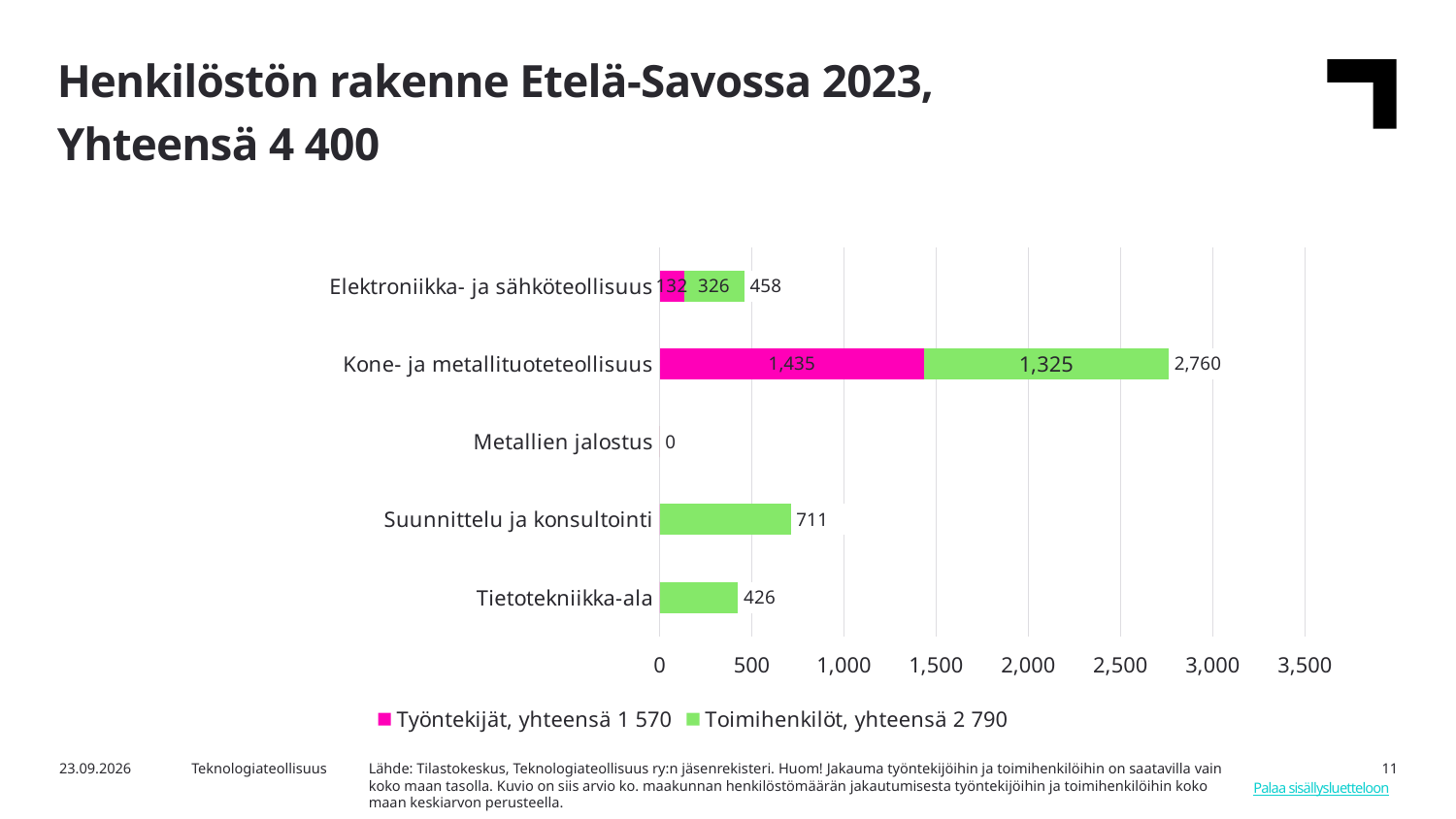
What is the Toimihenkilöt value for Kone- ja metallituoteteollisuus? 1,325 What is the difference between the Työntekijät and Toimihenkilöt values for Kone- ja metallituoteteollisuus? 110 What is the total of the stacked bar for Kone- ja metallituoteteollisuus? 2,760 What is the total shown for Suunnittelu ja konsultointi? 711 What is the Toimihenkilöt value for Elektroniikka- ja sähköteollisuus? 326 What kind of chart is shown on the slide? Stacked bar chart Which category has the highest total? Kone- ja metallituoteteollisuus What is the Työntekijät value for Kone- ja metallituoteteollisuus? 1,435 Which category has the lowest total? Metallien jalostus How many series does the legend list? 2 Which is larger: the total for Suunnittelu ja konsultointi or the total for Tietotekniikka-ala? Suunnittelu ja konsultointi How many categories are shown on the chart? 5